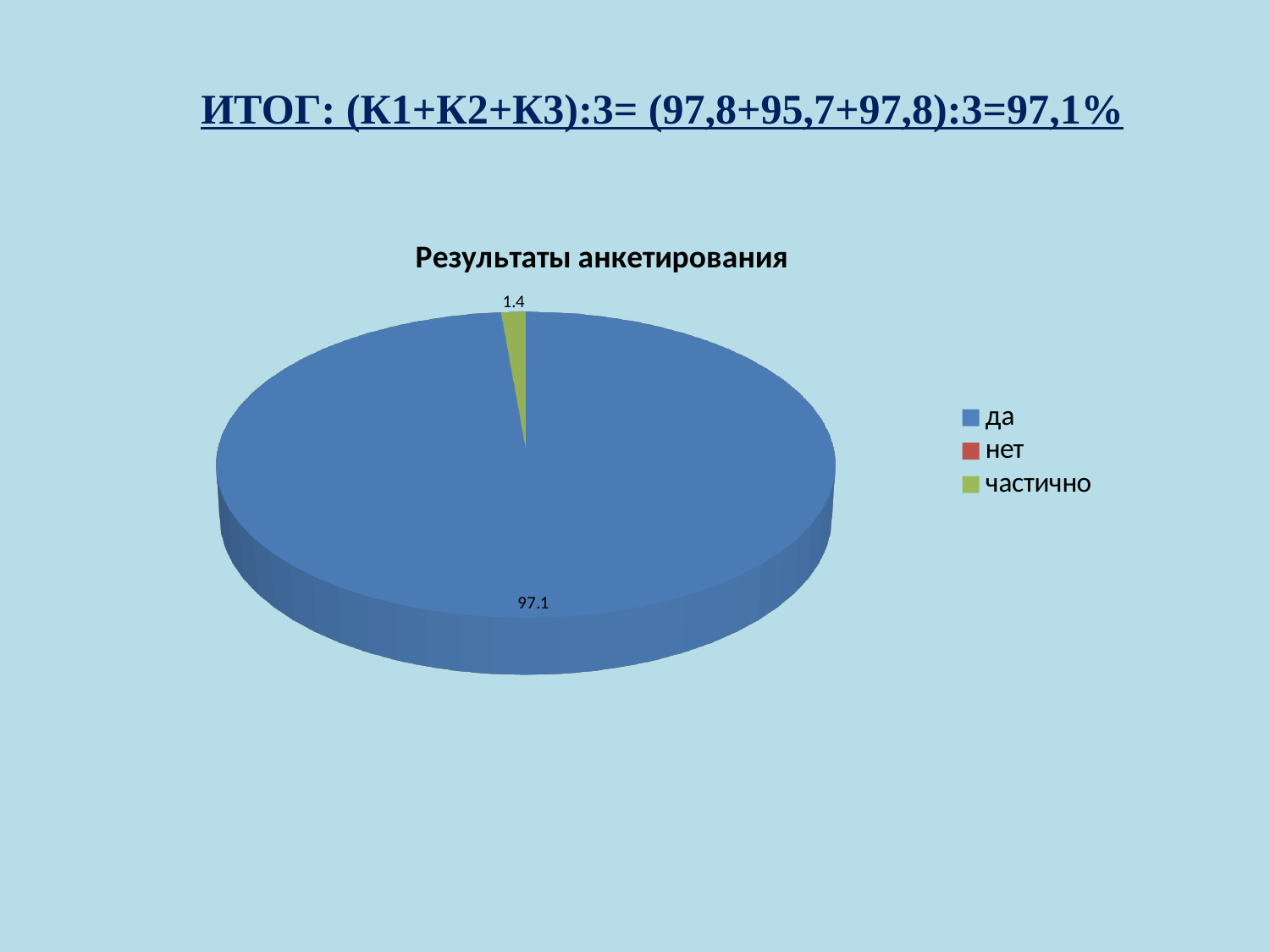
What is the value shown for the "частично" slice in the pie chart? 1.4 Which is larger in the pie chart, "да" or "частично"? да How many entries does the legend of the chart list? 3 What is the title of the chart? Результаты анкетирования What is the difference between the values for "да" and "частично" in the pie chart? 95.7 What is the value shown for the "да" slice in the pie chart? 97.1 What colour is the "да" slice in the pie chart? Blue What kind of chart is shown on the slide? Pie chart Which category has the largest slice in the pie chart? да